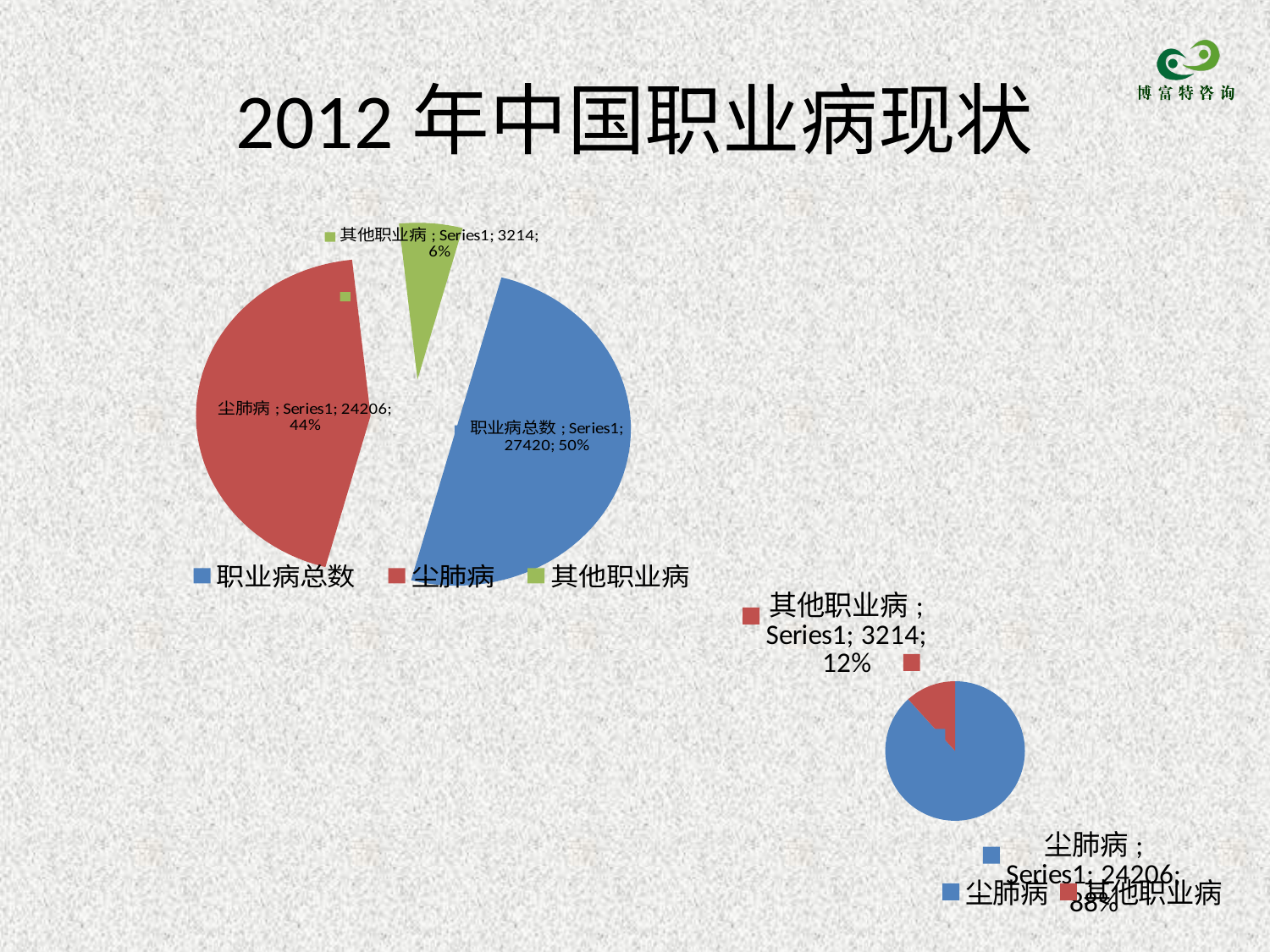
On the left pie chart, what percentage share does 其他职业病 have? 6% On the left pie chart, what is the value for 尘肺病? 24206 How many slices does the left pie chart have? 3 On the left pie chart, which category has the largest slice? 职业病总数 On the right pie chart, what percentage share does 尘肺病 have? 88% On the left pie chart, what is the value for 职业病总数? 27420 On the left pie chart, which category has the smallest slice? 其他职业病 What type of chart is shown on the right side of the slide? Pie chart On the right pie chart, which is larger, 尘肺病 or 其他职业病? 尘肺病 On the right pie chart, what is the value for 其他职业病? 3214 On the left pie chart, what percentage share does 尘肺病 have? 44% On the left pie chart, what is the difference between the values for 尘肺病 and 其他职业病? 20992